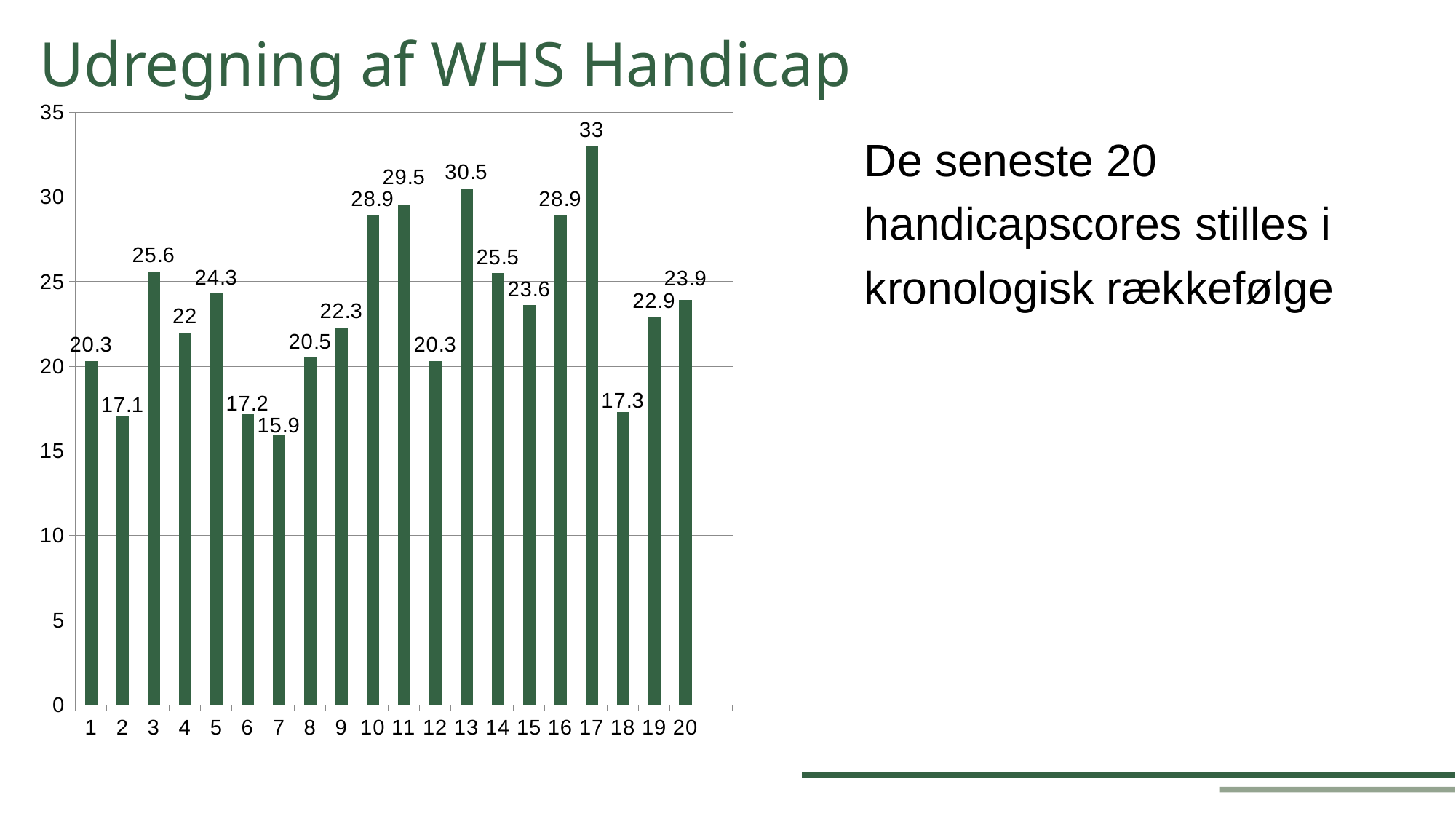
What is the value for category 17? 33 What is the difference between the values for category 17 and category 7? 17.1 Which category has the lowest value? 7 What is the difference between the values for category 5 and category 4? 2.3 Which category has the highest value? 17 What is the value for category 7? 15.9 Is the value for category 13 greater or less than 30? greater What is the value for category 3? 25.6 What colour are the bars in the chart? dark green What kind of chart is shown on the slide? bar chart How many categories are shown on the x axis? 20 Which is larger, the value for category 10 or the value for category 11? 11